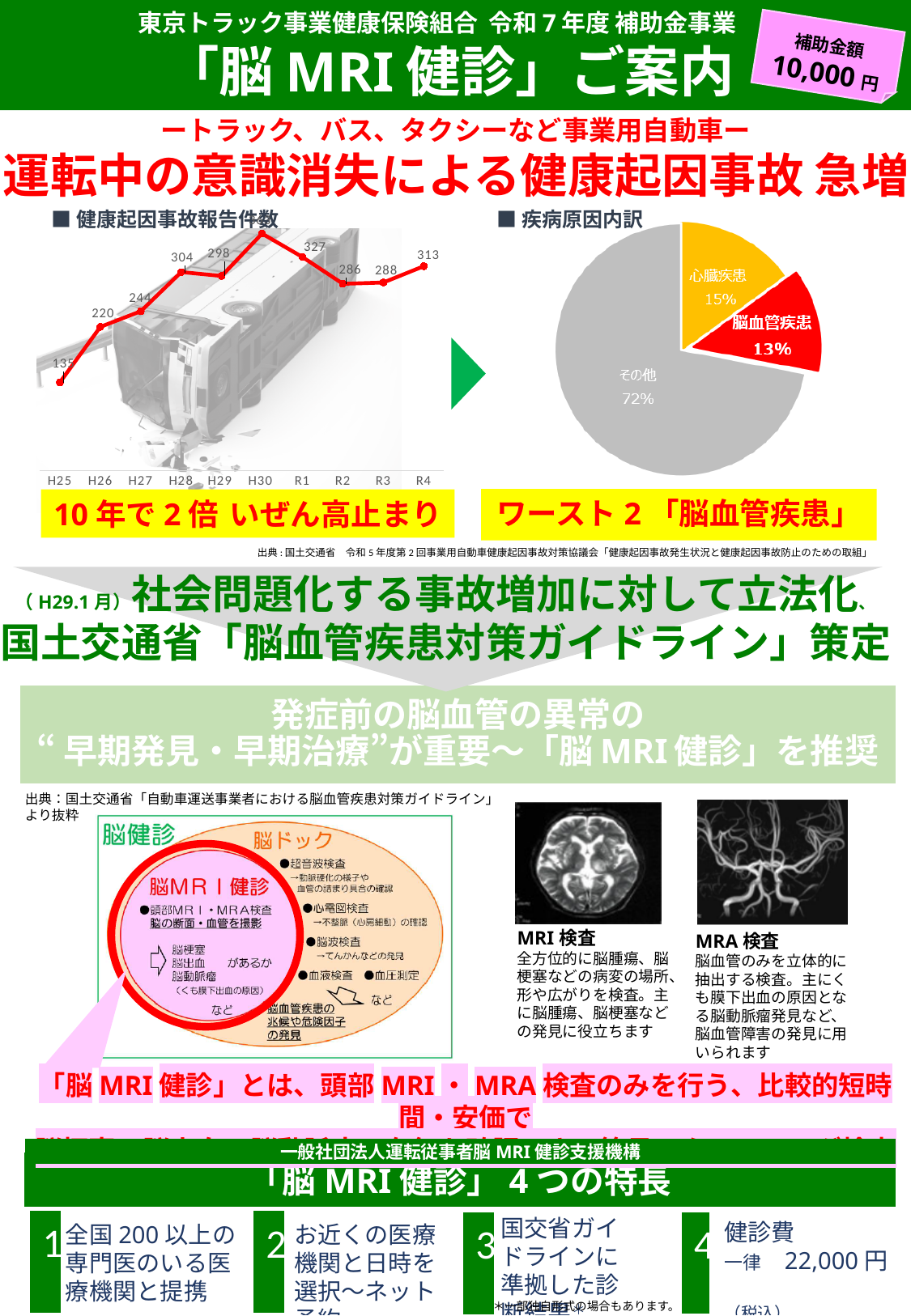
What kind of chart is the 疾病原因内訳 chart on the right? pie chart In the 疾病原因内訳 pie chart, how many slices are there? 3 In the 疾病原因内訳 pie chart, which slice is the largest? その他 In the 健康起因事故報告件数 chart, what is the value for R4? 313 In the 健康起因事故報告件数 chart, what is the difference between the values for R4 and H25? 178 In the 健康起因事故報告件数 chart, do the values rise or fall from H25 to H28? rise In the 疾病原因内訳 pie chart, what share does 脳血管疾患 have? 13% In the 健康起因事故報告件数 chart, which is larger, the value for H28 or the value for H29? H28 In the 健康起因事故報告件数 chart, how many years are shown on the x axis? 10 In the 健康起因事故報告件数 chart, which year has the lowest value? H25 What kind of chart is the 健康起因事故報告件数 chart on the left? line chart In the 健康起因事故報告件数 chart, what is the value for H25? 135